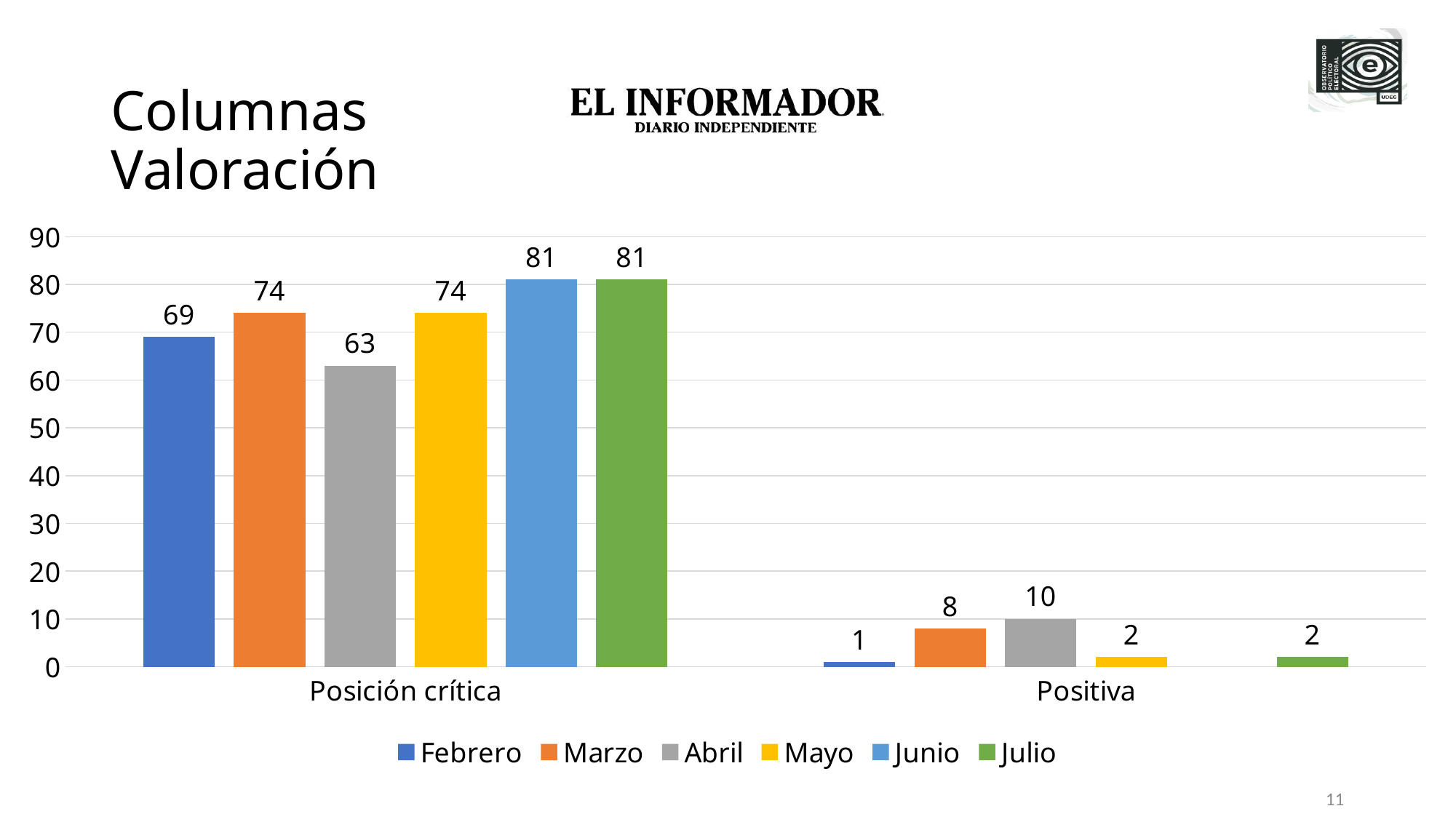
What is the difference between the Junio and Febrero values in the Posición crítica category? 12 Which month has the highest value in the Positiva category? Abril What is the value for Mayo in the Posición crítica category? 74 What is the difference between the Abril and Marzo values in the Positiva category? 2 How many series does the legend list? 6 Which month has the lowest value in the Posición crítica category? Abril Which is larger in the Posición crítica category, Marzo or Abril? Marzo What kind of chart is shown on the slide? Bar chart Is the value for Julio in the Posición crítica category greater or less than 80? greater What is the value for Febrero in the Posición crítica category? 69 What is the value for Abril in the Positiva category? 10 How many categories are shown on the x axis? 2